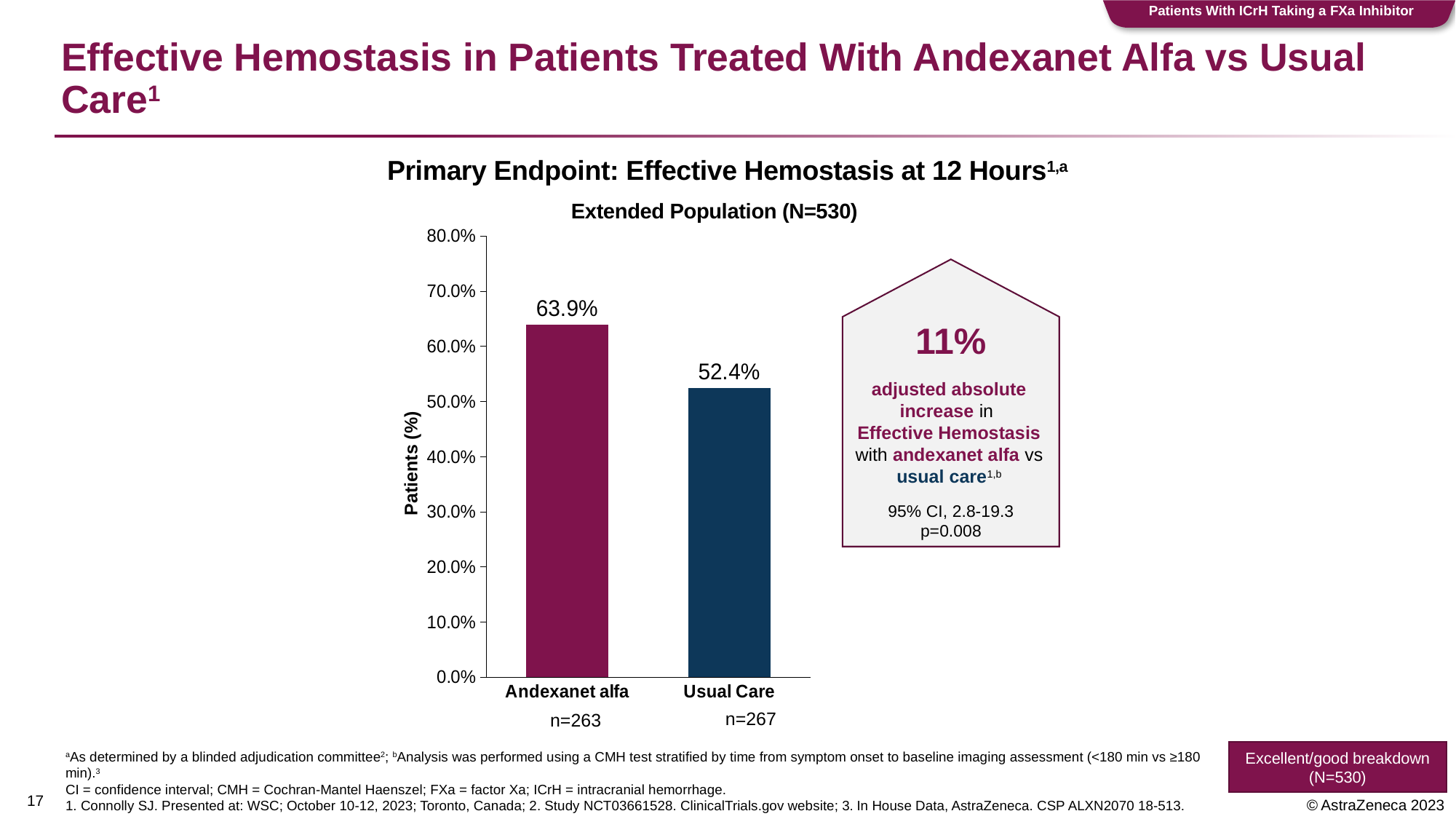
Which treatment group has the higher percentage of patients with effective hemostasis? Andexanet alfa What is the difference in percentage points between the Andexanet alfa and Usual Care bars? 11.5 Which treatment group has the lower percentage of patients with effective hemostasis? Usual Care What is the label of the y axis of the chart? Patients (%) What percentage of patients achieved effective hemostasis with Usual Care? 52.4% What is the sample size (n) shown under the Usual Care bar? n=267 What percentage of patients achieved effective hemostasis with Andexanet alfa? 63.9% What kind of chart is shown on the slide? Bar chart How many treatment groups are plotted in the chart? 2 Is the value for Usual Care greater or less than 60.0%? less What is the highest value shown on the y axis of the chart? 80.0% Is the value for Andexanet alfa greater or less than 60.0%? greater